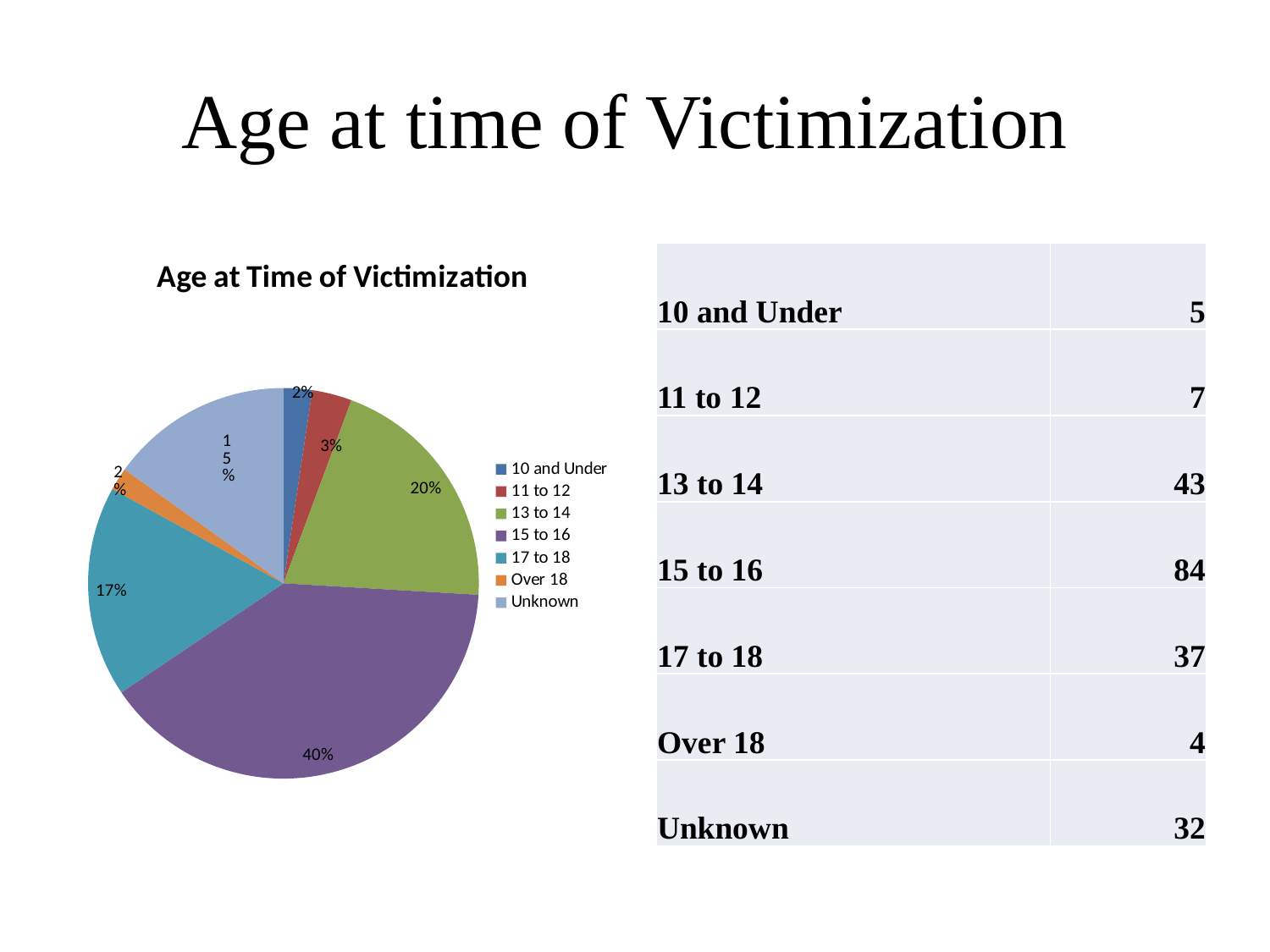
What share of the pie does the 17 to 18 slice represent? 17% What is the difference in percentage points between the 15 to 16 slice and the 13 to 14 slice? 20% What type of chart is shown on the slide? pie chart What is the title of the chart? Age at Time of Victimization Which colour is used for the 15 to 16 slice in the pie chart? purple Which slice is larger, 13 to 14 or 17 to 18? 13 to 14 What share of the pie does the 13 to 14 slice represent? 20% Which category has the largest slice of the pie? 15 to 16 What share of the pie does the 11 to 12 slice represent? 3% How many categories does the pie chart's legend list? 7